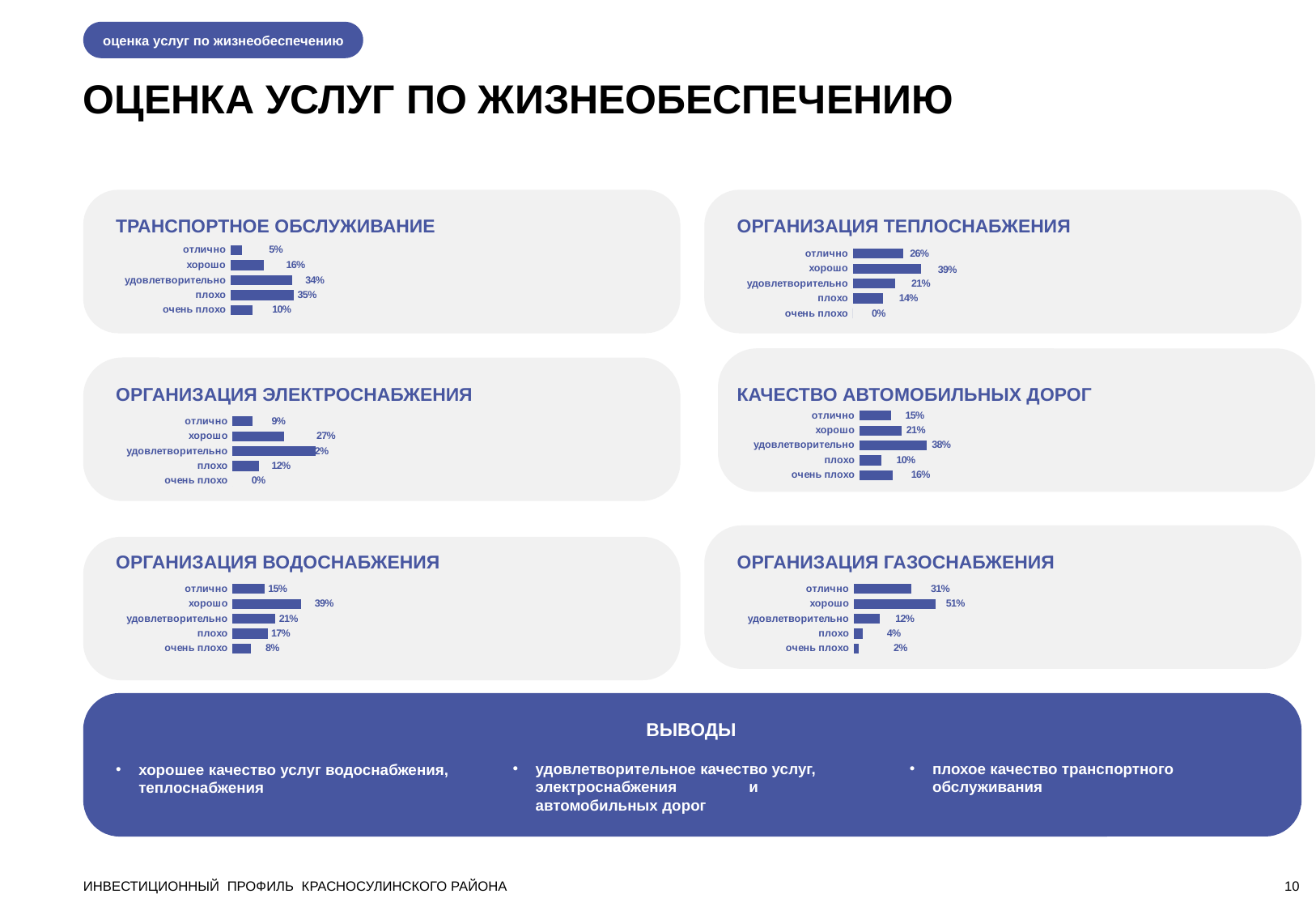
In the 'ОРГАНИЗАЦИЯ ТЕПЛОСНАБЖЕНИЯ' chart, what is the value for 'хорошо'? 39% In the 'ОРГАНИЗАЦИЯ ВОДОСНАБЖЕНИЯ' chart, what is the difference between 'хорошо' and 'удовлетворительно'? 18% In the 'ОРГАНИЗАЦИЯ ЭЛЕКТРОСНАБЖЕНИЯ' chart, what is the value for 'хорошо'? 27% In the 'ТРАНСПОРТНОЕ ОБСЛУЖИВАНИЕ' chart, what is the value for 'плохо'? 35% What type of chart is used in the 'ОРГАНИЗАЦИЯ ВОДОСНАБЖЕНИЯ' panel? Bar chart In the 'ОРГАНИЗАЦИЯ ТЕПЛОСНАБЖЕНИЯ' chart, what is the difference between 'отлично' and 'плохо'? 12% How many categories does the 'ОРГАНИЗАЦИЯ ГАЗОСНАБЖЕНИЯ' chart show? 5 In the 'ОРГАНИЗАЦИЯ ГАЗОСНАБЖЕНИЯ' chart, what is the value for 'отлично'? 31% In the 'КАЧЕСТВО АВТОМОБИЛЬНЫХ ДОРОГ' chart, which category has the highest value? удовлетворительно In the 'ОРГАНИЗАЦИЯ ЭЛЕКТРОСНАБЖЕНИЯ' chart, which is larger, 'отлично' or 'плохо'? плохо In the 'КАЧЕСТВО АВТОМОБИЛЬНЫХ ДОРОГ' chart, what is the value for 'очень плохо'? 16% In the 'ТРАНСПОРТНОЕ ОБСЛУЖИВАНИЕ' chart, which category has the lowest value? отлично